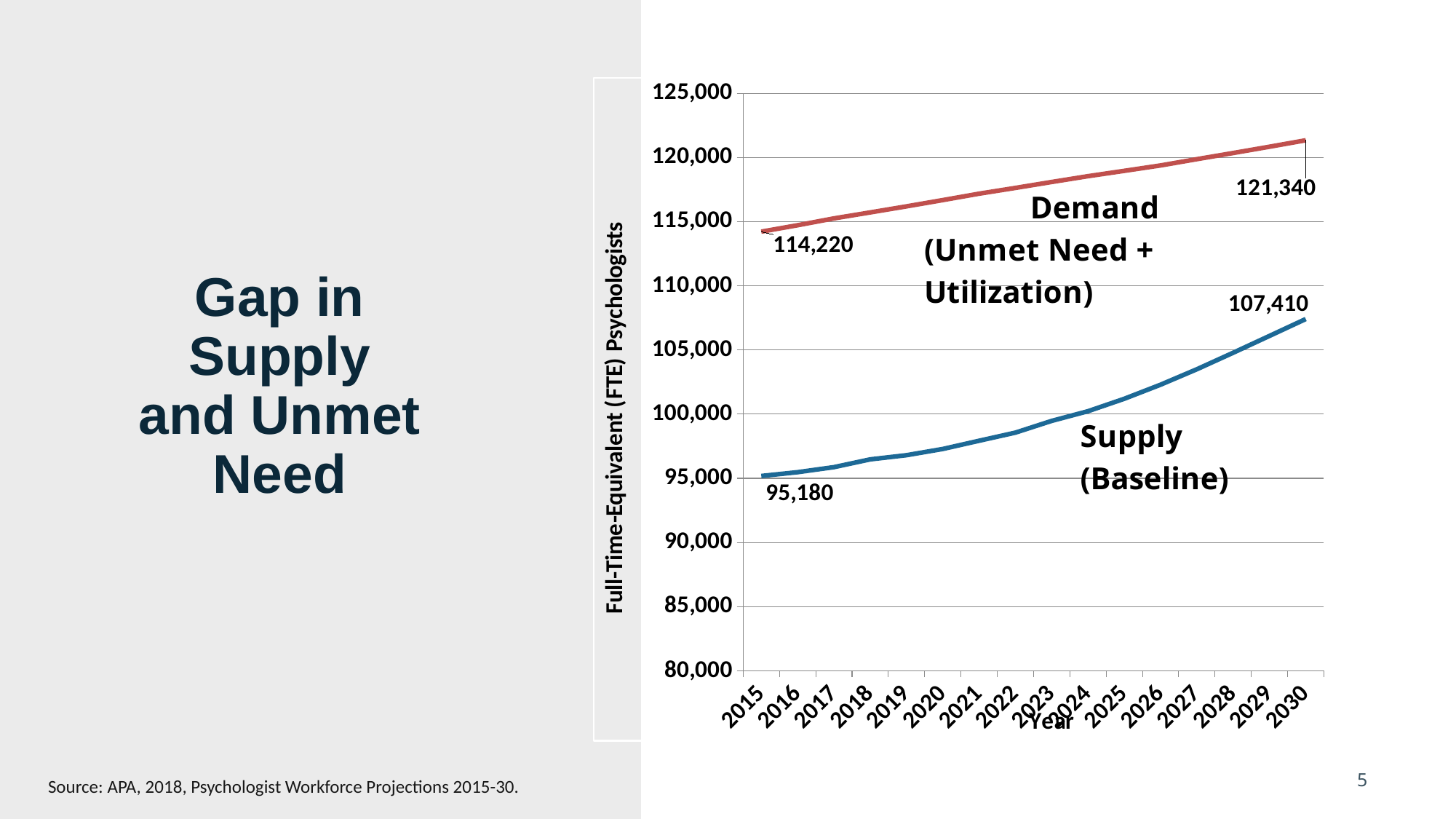
Does the Supply (Baseline) line rise or fall from 2015 to 2030? Rises What is the Supply (Baseline) value in 2030? 107,410 By how much does Supply (Baseline) increase from 2015 to 2030? 12,230 What kind of chart is shown on the slide? Line chart What is the Demand (Unmet Need + Utilization) value in 2015? 114,220 What is the Supply (Baseline) value in 2015? 95,180 What is the difference between Demand and Supply in 2015? 19,040 How many years are shown on the x axis? 16 Is the Supply (Baseline) value for 2022 greater or less than 100,000? less Which series is higher in 2030, Demand or Supply? Demand What is the Demand (Unmet Need + Utilization) value in 2030? 121,340 What is the difference between Demand and Supply in 2030? 13,930